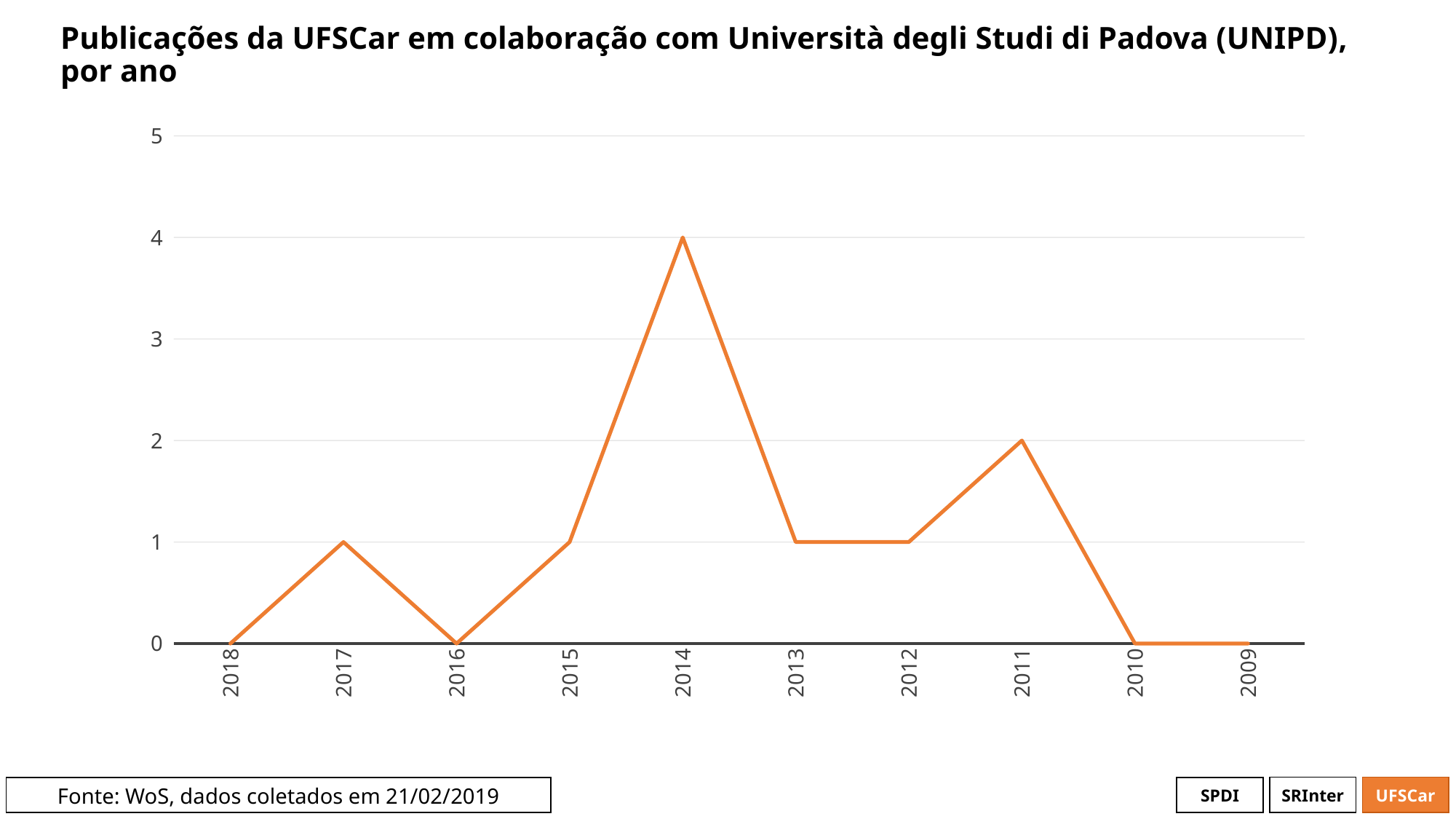
What is the difference between the values for 2014 and 2011? 2 What is the value for 2014? 4 Is the value for 2014 greater or less than 3? greater Moving from 2015 to 2014 along the x axis, does the line rise or fall? rise What kind of chart is shown on the slide? line chart Which year has the highest value? 2014 How many years are shown on the x axis? 10 What colour is the line in the chart? orange What is the value for 2010? 0 What is the value for 2011? 2 What is the value for 2017? 1 Which is larger, the value for 2011 or the value for 2013? 2011